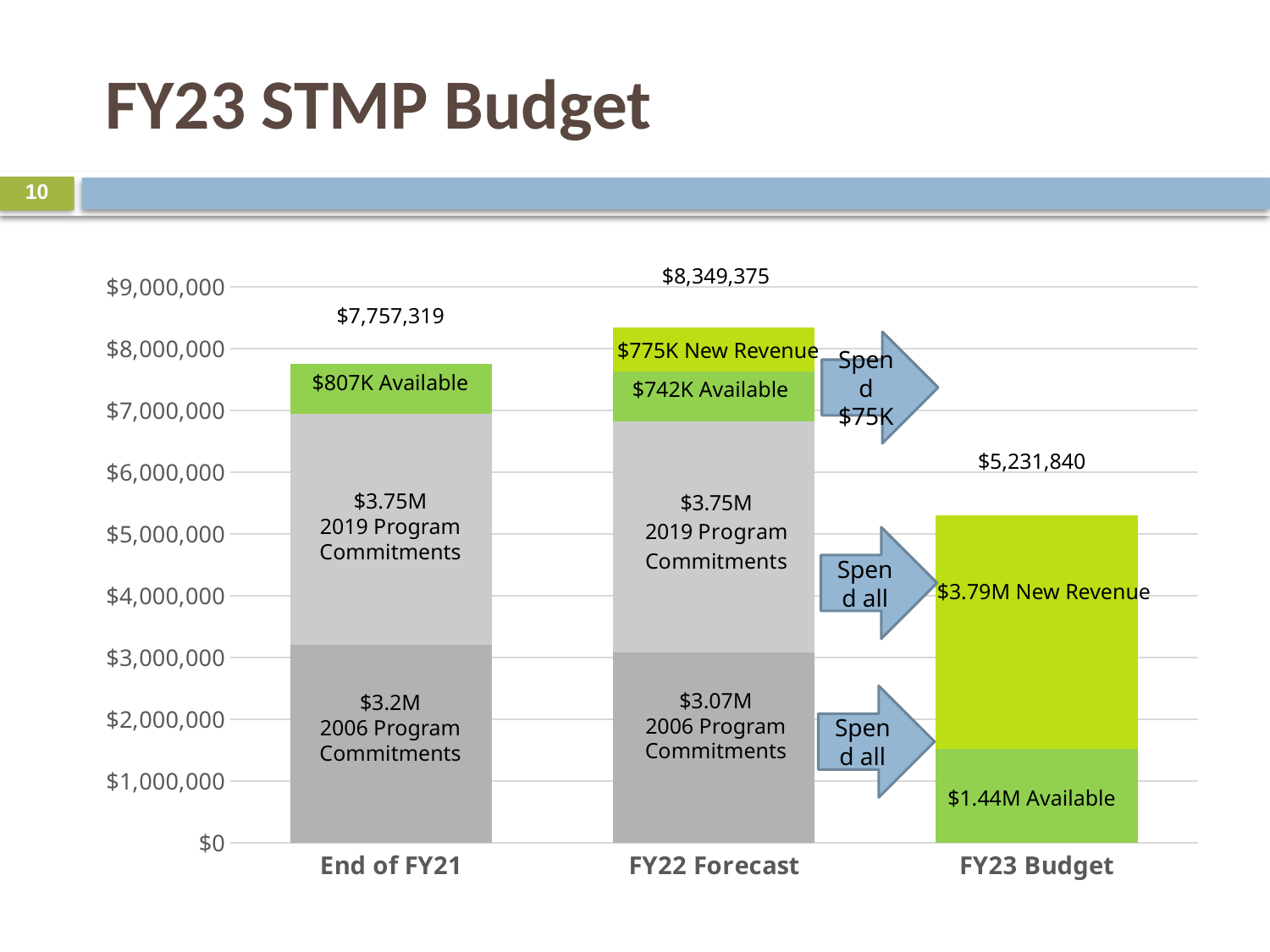
Which category has the highest total? FY22 Forecast What is the Available amount labelled in the End of FY21 bar? $807K How many categories are shown on the x axis? 3 What kind of chart is shown on the slide? stacked bar chart What is the total value printed above the FY23 Budget bar? $5,231,840 Which category has the lowest total? FY23 Budget What is the total value printed above the FY22 Forecast bar? $8,349,375 What is the New Revenue amount labelled in the FY23 Budget bar? $3.79M What is the difference between the FY22 Forecast total and the End of FY21 total? $592,056 Is the total for FY23 Budget greater or less than $6,000,000? less What is the 2006 Program Commitments amount labelled in the FY22 Forecast bar? $3.07M What is the total value printed above the End of FY21 bar? $7,757,319